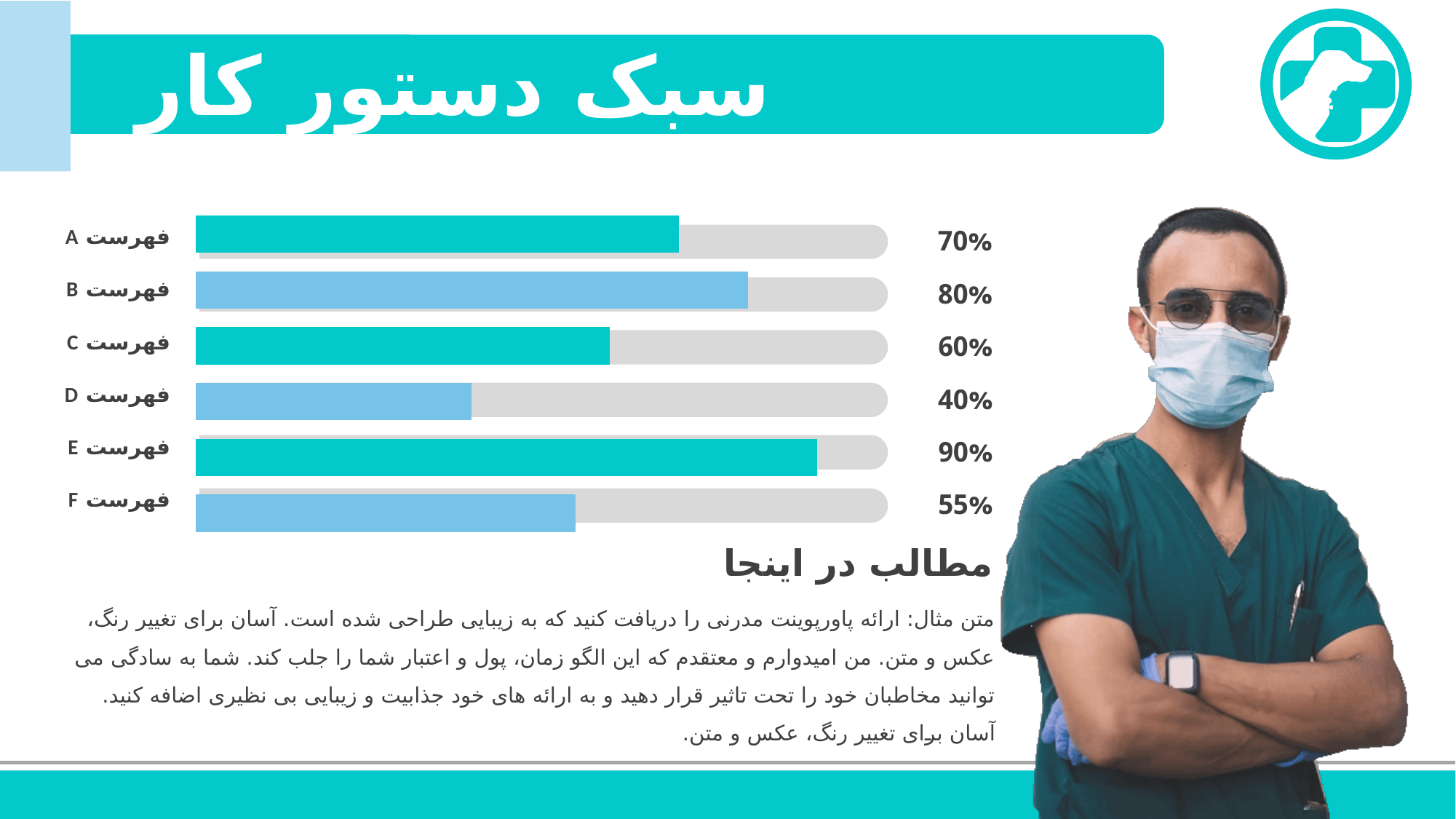
What is the difference between the values for فهرست B and فهرست C? 20% Which category has the lowest value? فهرست D How many categories are shown in the bar chart? 6 What is the value for فهرست F? 55% Which is larger, the value for فهرست A or the value for فهرست B? فهرست B What is the value for فهرست A? 70% What is the value for فهرست D? 40% What colour is the bar for فهرست B? Light blue Which is larger, the value for فهرست C or the value for فهرست F? فهرست C Which category has the highest value? فهرست E What kind of chart is shown on the slide? Bar chart What is the difference between the values for فهرست E and فهرست F? 35%